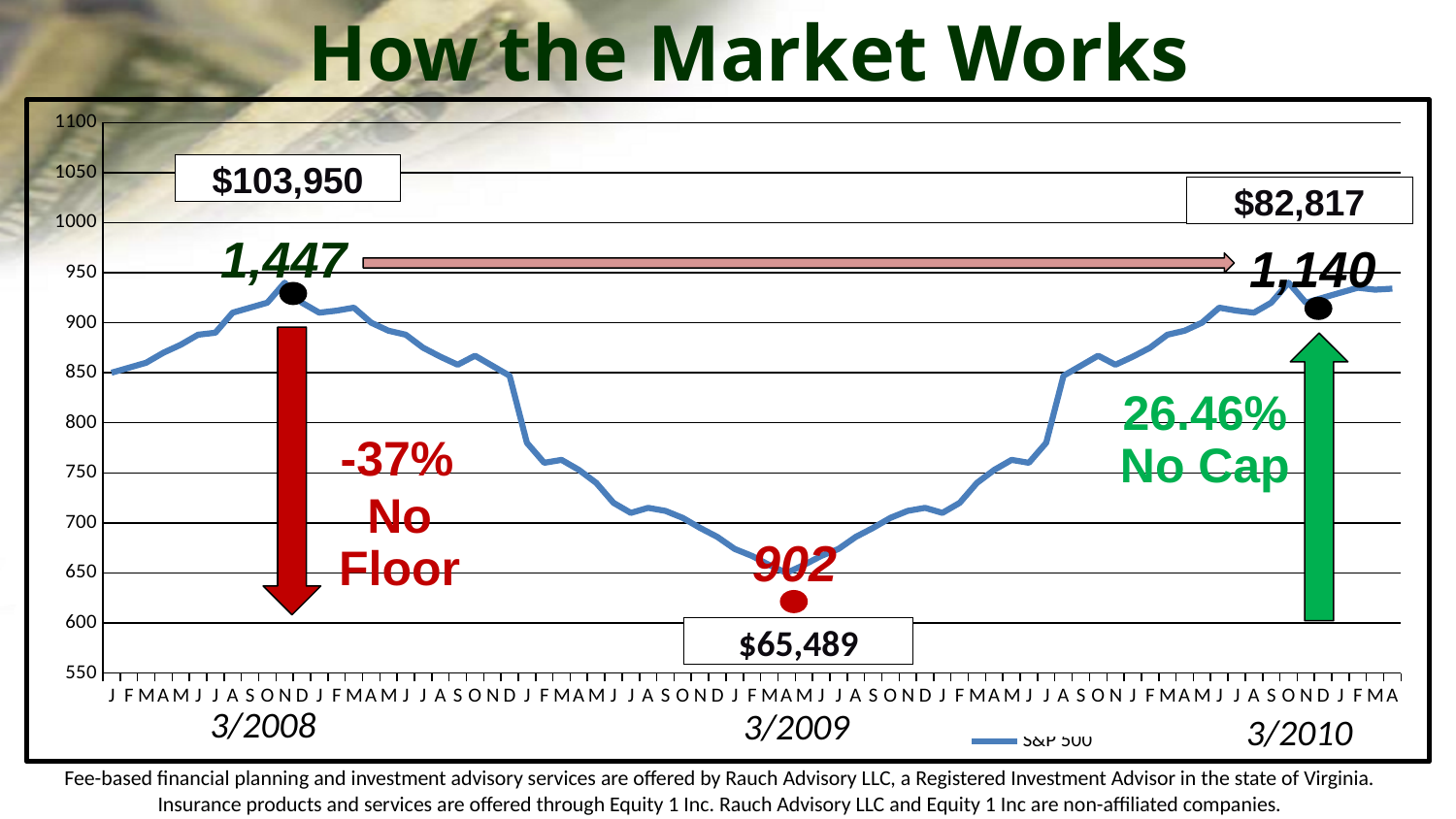
What kind of chart is shown on the slide? line chart Which of the three labeled dates has the highest labeled S&P 500 value? 3/2008 How many series does the legend list? 1 What S&P 500 value is labeled at the 3/2009 point? 902 What is the difference between the labeled S&P 500 values at 3/2008 and 3/2009? 545 What S&P 500 value is labeled at the 3/2010 point? 1,140 What S&P 500 value is labeled at the 3/2008 point? 1,447 What is the difference between the dollar amounts shown for 3/2010 and 3/2009? $17,328 Does the S&P 500 line rise or fall between 3/2009 and 3/2010? rise What dollar amount is shown in the box near the 3/2009 low point? $65,489 What dollar amount is shown in the box near the 3/2010 point? $82,817 Which of the three labeled dates has the lowest labeled S&P 500 value? 3/2009